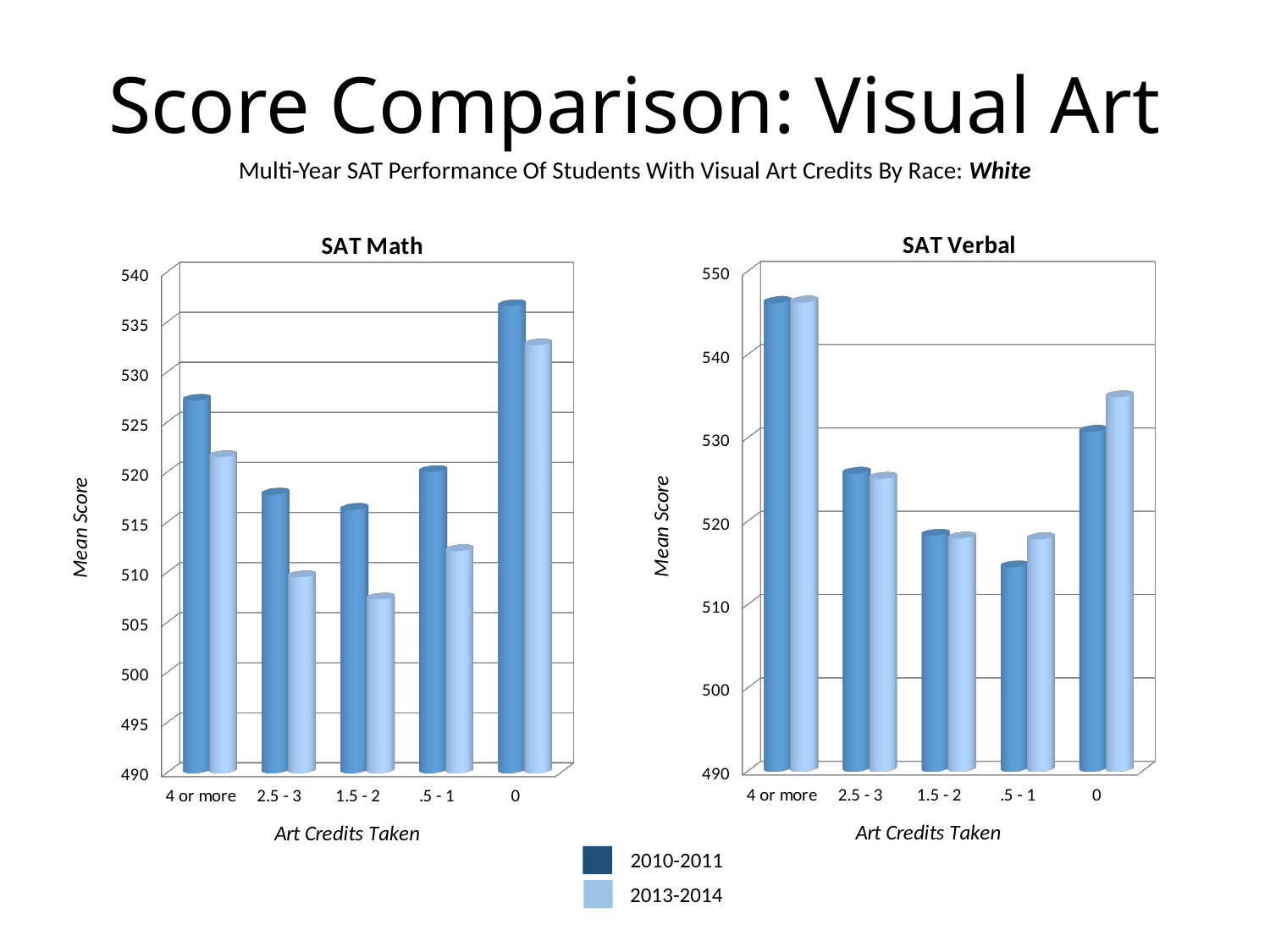
In the SAT Verbal chart, which category has the highest 2013-2014 score? 4 or more In the SAT Math chart, is the 2010-2011 value for 0 credits greater or less than 530? greater In the SAT Verbal chart, which category has the lowest 2010-2011 score? .5 - 1 In the SAT Math chart, for 2.5 - 3 credits, which series has the higher score, 2010-2011 or 2013-2014? 2010-2011 In the SAT Verbal chart, how many art-credit categories are shown on the x axis? 5 In the SAT Verbal chart, for 0 credits, which series has the higher score, 2010-2011 or 2013-2014? 2013-2014 What kind of chart is the SAT Math chart? bar chart In the SAT Verbal chart, is the 2010-2011 value for 4 or more credits greater or less than 540? greater In the SAT Math chart, which category has the lowest 2013-2014 score? 1.5 - 2 How many series does the legend list? 2 In the SAT Math chart, is the 2013-2014 value for 1.5 - 2 credits greater or less than 510? less In the SAT Math chart, which category has the highest 2010-2011 score? 0